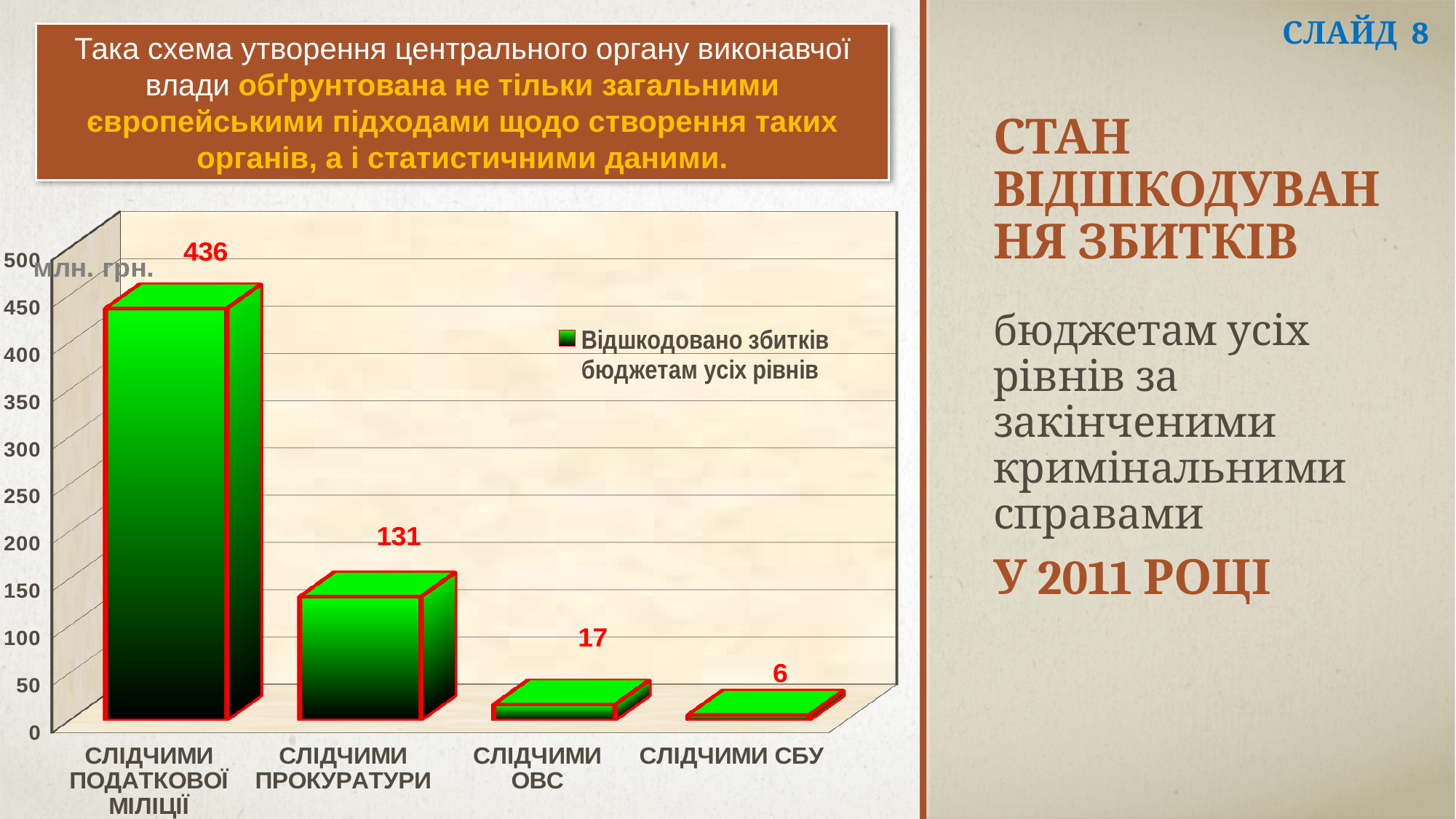
What value is shown for СЛІДЧИМИ ПОДАТКОВОЇ МІЛІЦІЇ? 436 Which is larger, the value for СЛІДЧИМИ ОВС or for СЛІДЧИМИ СБУ? СЛІДЧИМИ ОВС What is the difference between the values for СЛІДЧИМИ ПОДАТКОВОЇ МІЛІЦІЇ and СЛІДЧИМИ ПРОКУРАТУРИ? 305 What value is shown for СЛІДЧИМИ СБУ? 6 Which category has the highest value? СЛІДЧИМИ ПОДАТКОВОЇ МІЛІЦІЇ How many series does the legend list? 1 What unit is indicated on the chart's value axis? млн. грн. What value is shown for СЛІДЧИМИ ОВС? 17 What value is shown for СЛІДЧИМИ ПРОКУРАТУРИ? 131 How many categories are shown on the x axis? 4 What kind of chart is shown? bar chart Which category has the lowest value? СЛІДЧИМИ СБУ